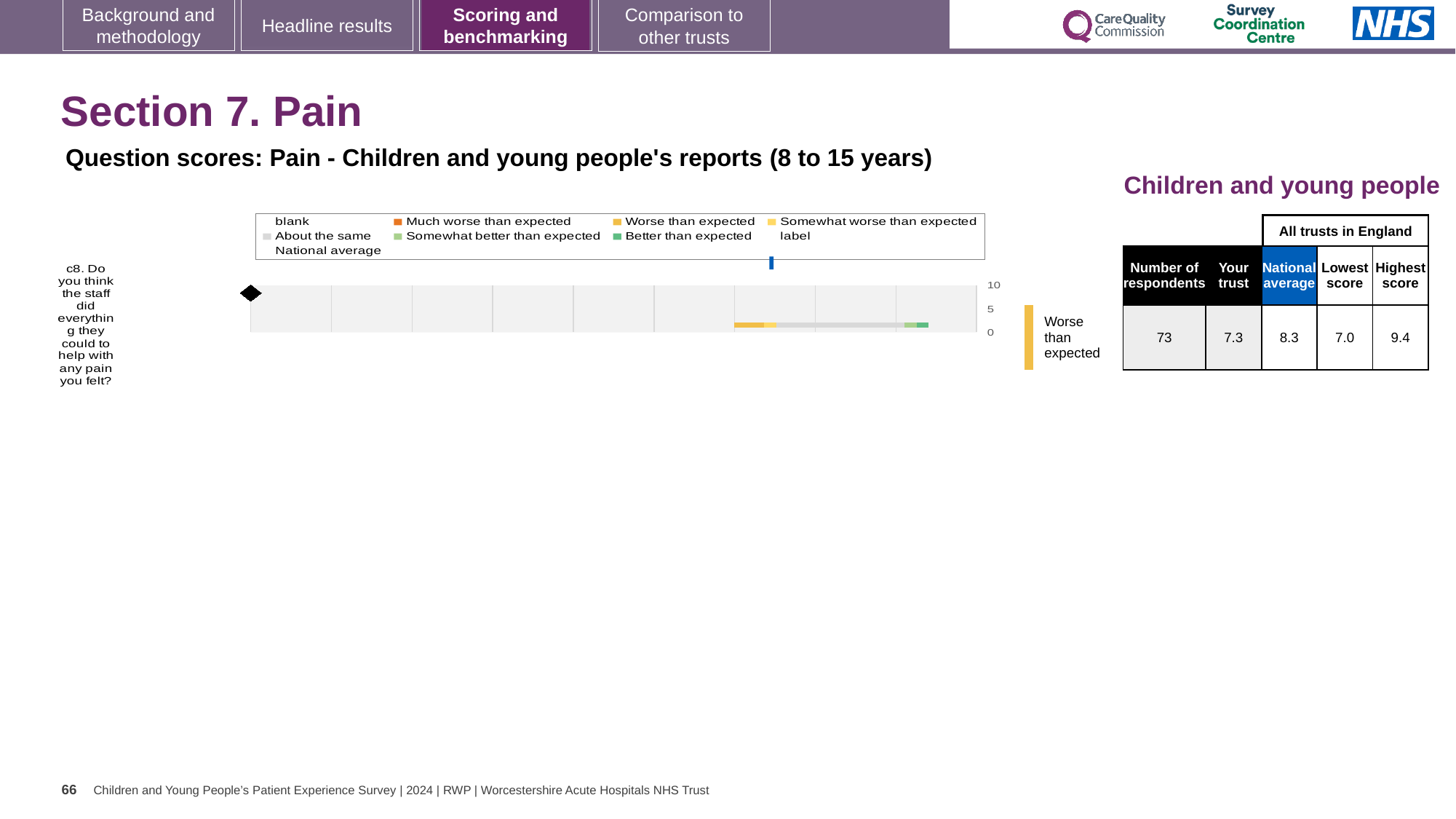
What is the difference between the Highest score and the Lowest score for question c8? 2.4 In the table beside the chart, what is the Highest score among all trusts in England for question c8? 9.4 In the table beside the chart, what is the National average score for question c8? 8.3 In the table beside the chart, what is the score for Your trust on question c8? 7.3 What is the difference between the National average and the Your trust score for question c8? 1.0 How many survey questions (categories) are plotted in the chart? 1 What kind of chart is shown on the slide for question c8? bar chart Which is larger for question c8, the Your trust score or the National average score? National average In the table beside the chart, what is the Lowest score among all trusts in England for question c8? 7.0 In the table beside the chart, how many respondents answered question c8? 73 Which question is plotted in the chart? c8. Do you think the staff did everything they could to help with any pain you felt? What rating label is shown beside the chart for question c8? Worse than expected